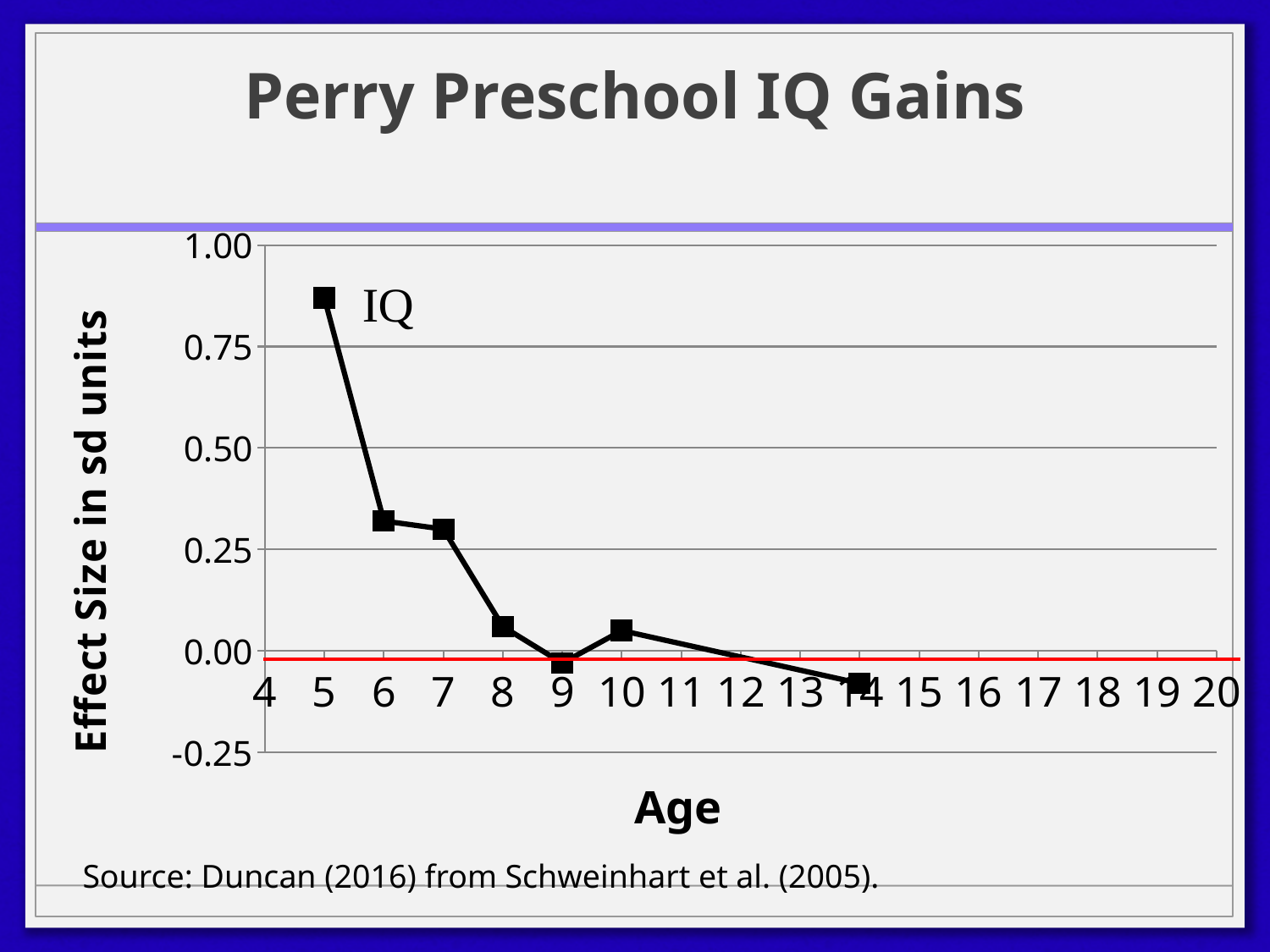
Is the IQ effect size at age 8 greater or less than 0.25? less How many series are plotted on the chart? 1 What is the label of the y axis? Effect Size in sd units What kind of chart is shown on the slide? line chart What is the title of the chart? Perry Preschool IQ Gains Which has the larger IQ effect size, age 6 or age 8? age 6 Is the IQ effect size at age 5 greater or less than 0.75? greater How many data points are plotted on the IQ line? 7 Is the IQ effect size at age 5 greater or less than 1.00? less Does the IQ effect size generally rise or fall as age increases? fall At which age is the IQ effect size highest? 5